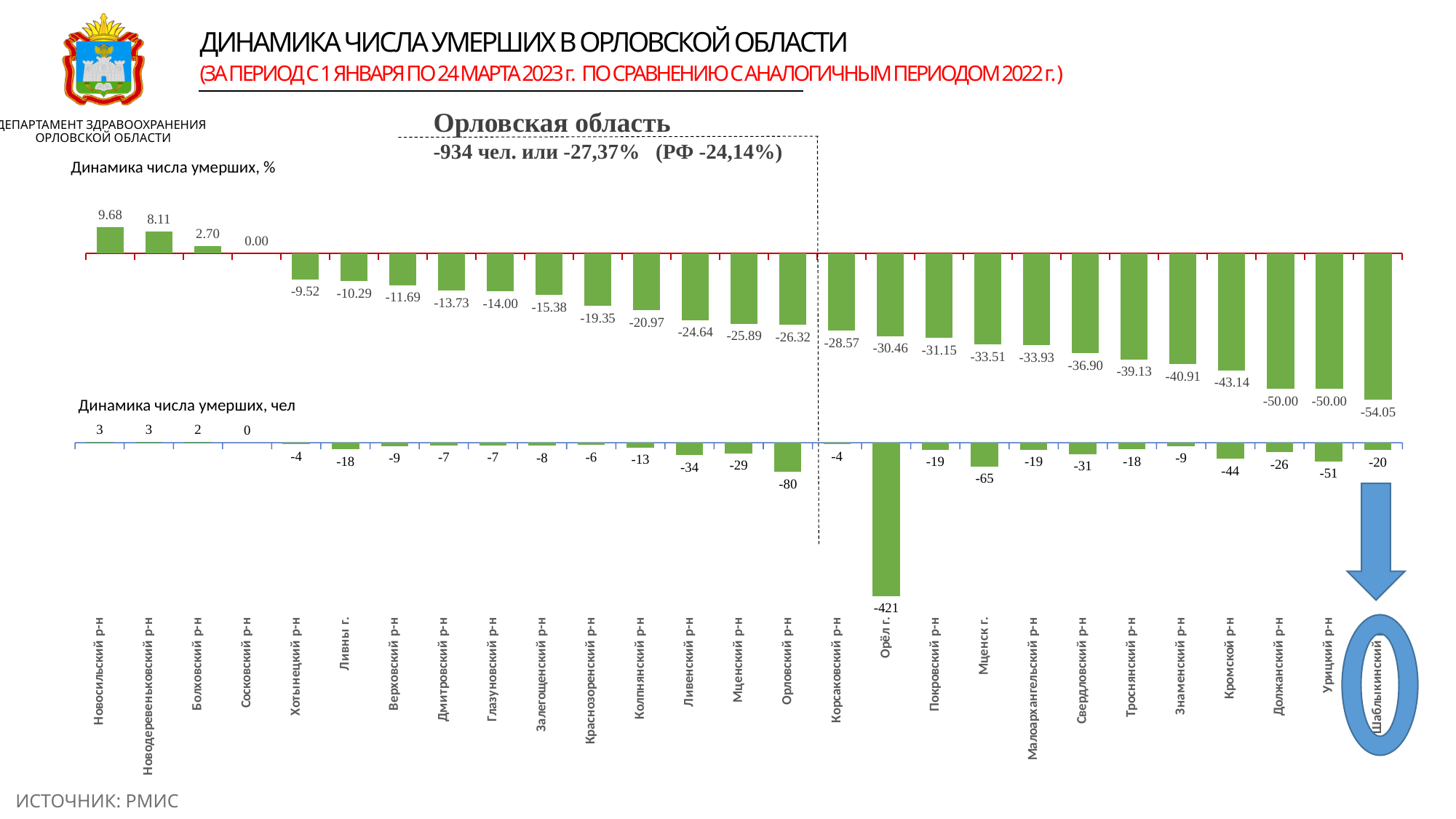
In the top chart 'Динамика числа умерших, %', which category has the highest value? Новосильский р-н In the top chart 'Динамика числа умерших, %', do the values rise or fall from left to right along the x axis? fall What kind of chart is the bottom chart 'Динамика числа умерших, чел'? bar chart How many categories are shown in the top chart 'Динамика числа умерших, %'? 27 In the bottom chart 'Динамика числа умерших, чел', which category has the lowest value? Орёл г. In the bottom chart 'Динамика числа умерших, чел', which is larger, the value for Орловский р-н or the value for Ливенский р-н? Ливенский р-н In the bottom chart 'Динамика числа умерших, чел', what is the value for Орёл г.? -421 In the bottom chart 'Динамика числа умерших, чел', what is the value for Мценск г.? -65 In the bottom chart 'Динамика числа умерших, чел', what is the value for Урицкий р-н? -51 In the top chart 'Динамика числа умерших, %', what is the difference between the values for Новосильский р-н and Новодеревеньковский р-н? 1.57 In the top chart 'Динамика числа умерших, %', what is the value for Новосильский р-н? 9.68 In the top chart 'Динамика числа умерших, %', what is the value for Шаблыкинский? -54.05